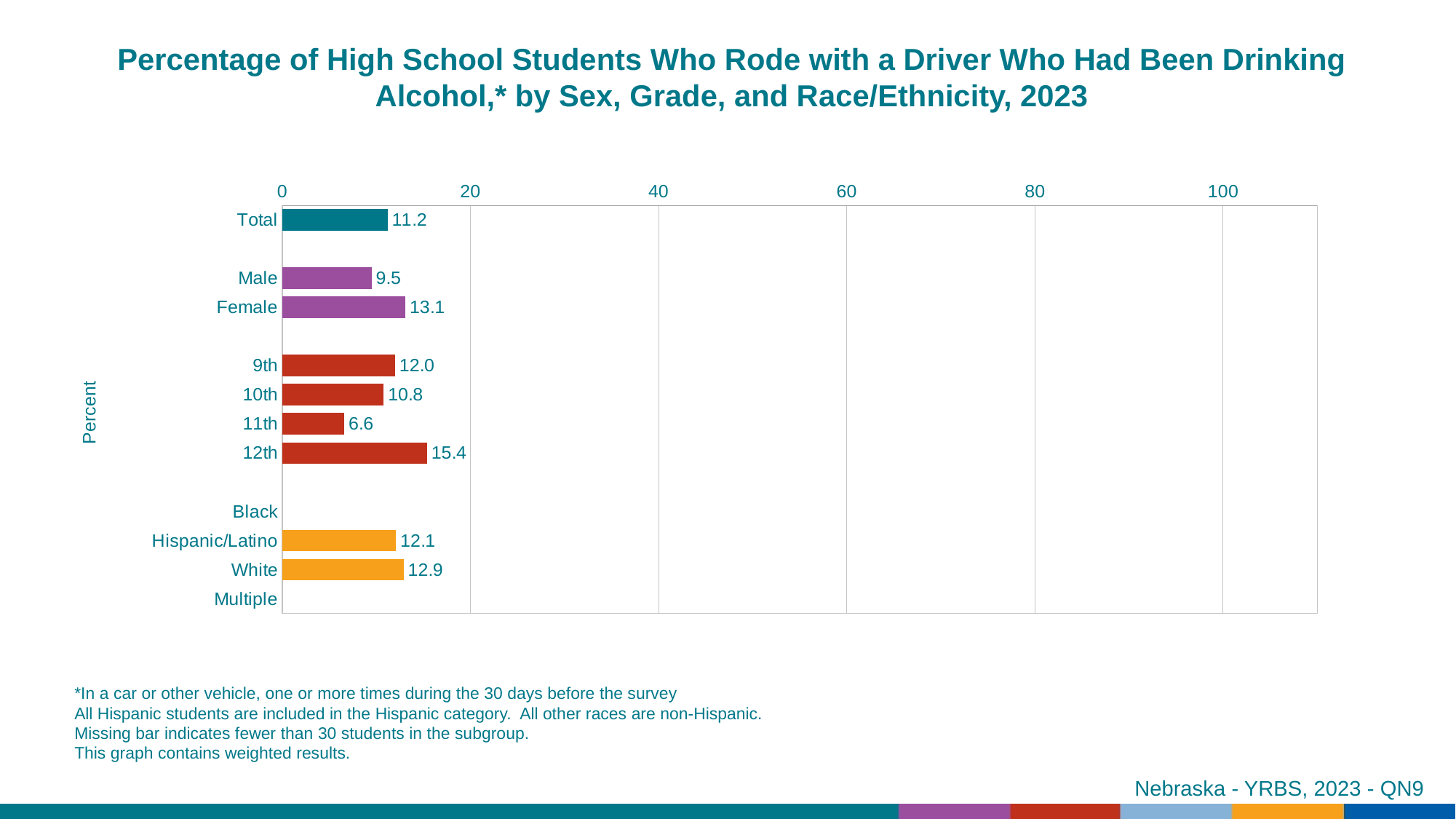
What kind of chart is shown on the slide? bar chart Which grade has the highest value? 12th How many categories are listed on the vertical axis? 11 What is the value for White? 12.9 Which is larger, the value for Hispanic/Latino or the value for White? White What is the value for 11th grade? 6.6 Which categories have no bar shown? Black and Multiple Which category has the lowest value among those with a bar shown? 11th What is the value for Total? 11.2 What is the value for Female? 13.1 What is the difference between the Female and Male values? 3.6 Is the value for 12th grade greater or less than 20? less